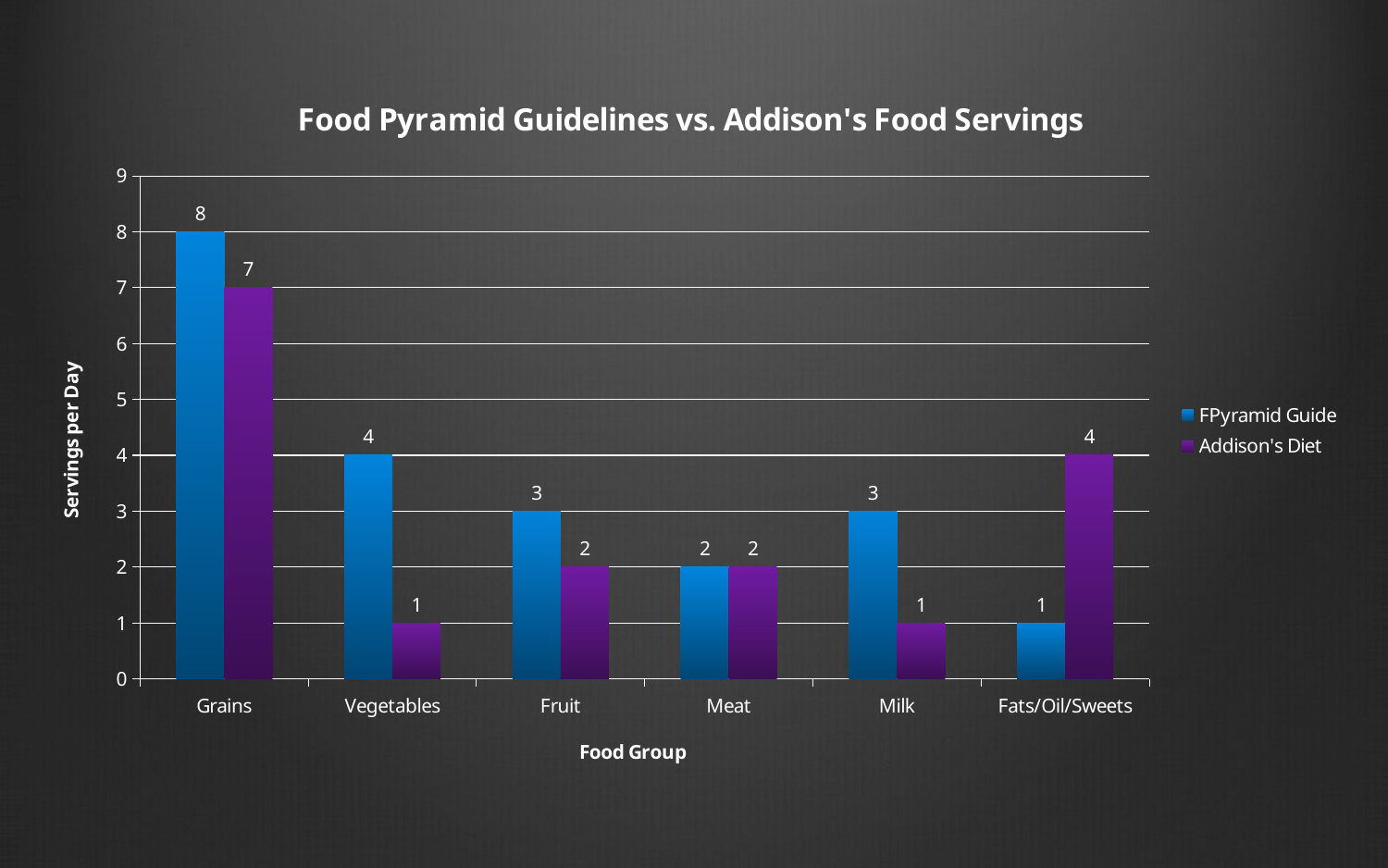
What kind of chart is shown on the slide? Bar chart What is the difference between the FPyramid Guide and Addison's Diet values for Vegetables? 3 What is the Addison's Diet value for Fats/Oil/Sweets? 4 What is the title of the chart? Food Pyramid Guidelines vs. Addison's Food Servings Which food group has the highest Addison's Diet value? Grains How many series does the legend list? 2 How many food groups are shown on the x axis? 6 What is the Addison's Diet value for Vegetables? 1 Which is larger for Milk: the FPyramid Guide value or the Addison's Diet value? FPyramid Guide Which food group has the lowest FPyramid Guide value? Fats/Oil/Sweets What is the label of the y axis? Servings per Day What is the FPyramid Guide value for Grains? 8